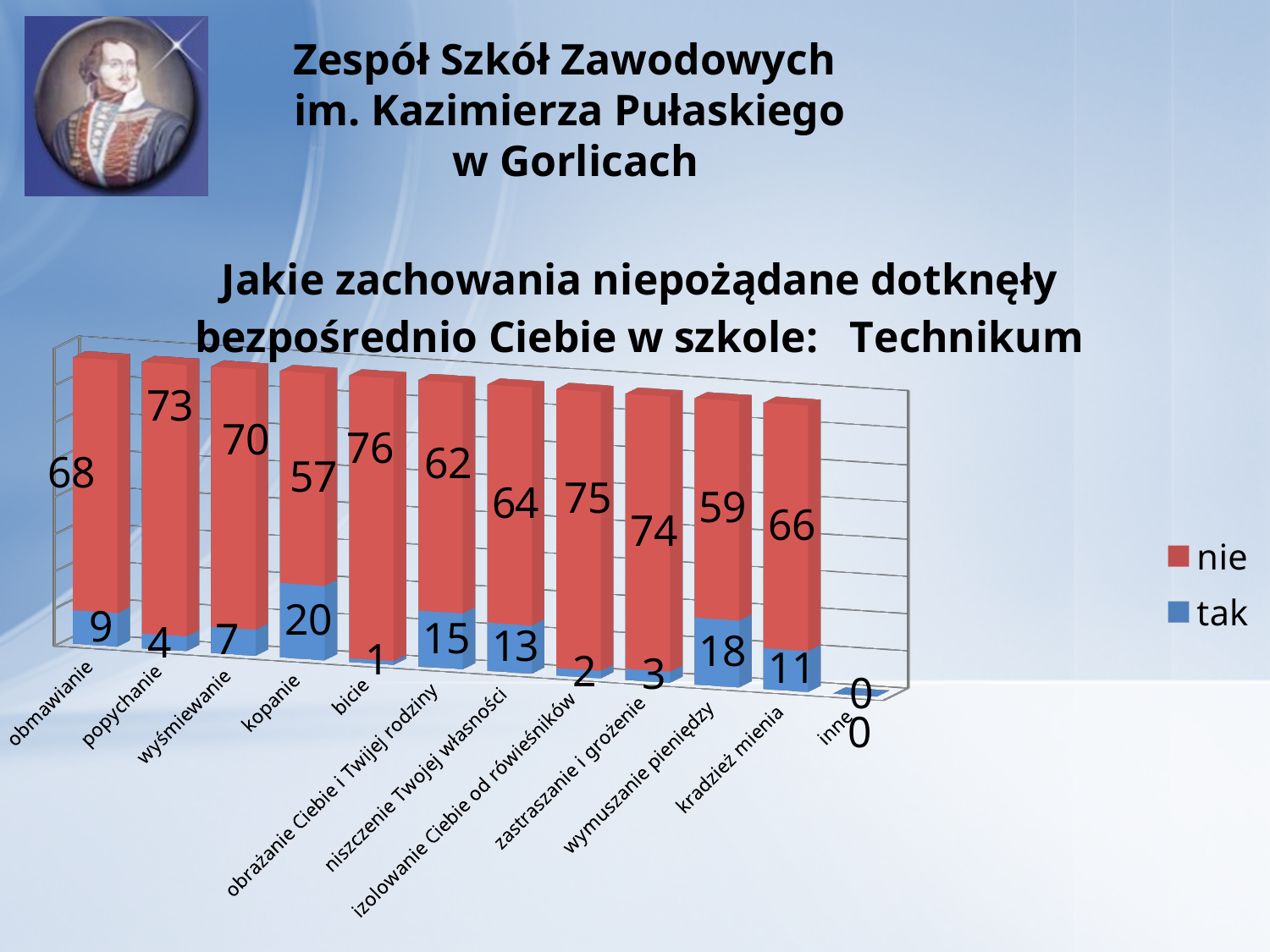
Which is larger: the "tak" value for obmawianie or the "tak" value for kradzież mienia? kradzież mienia What is the value of "nie" for bicie? 76 What is the difference between the "nie" value for bicie and the "nie" value for kopanie? 19 Which category has the lowest "nie" value? inne How many series does the legend list? 2 Which category has the highest "tak" value? kopanie What is the total of the stacked bar for popychanie? 77 What is the value of "nie" for kradzież mienia? 66 What is the value of "tak" for kopanie? 20 What is the value of "tak" for wymuszanie pieniędzy? 18 How many categories are shown on the x axis? 12 What kind of chart is shown on the slide? stacked bar chart